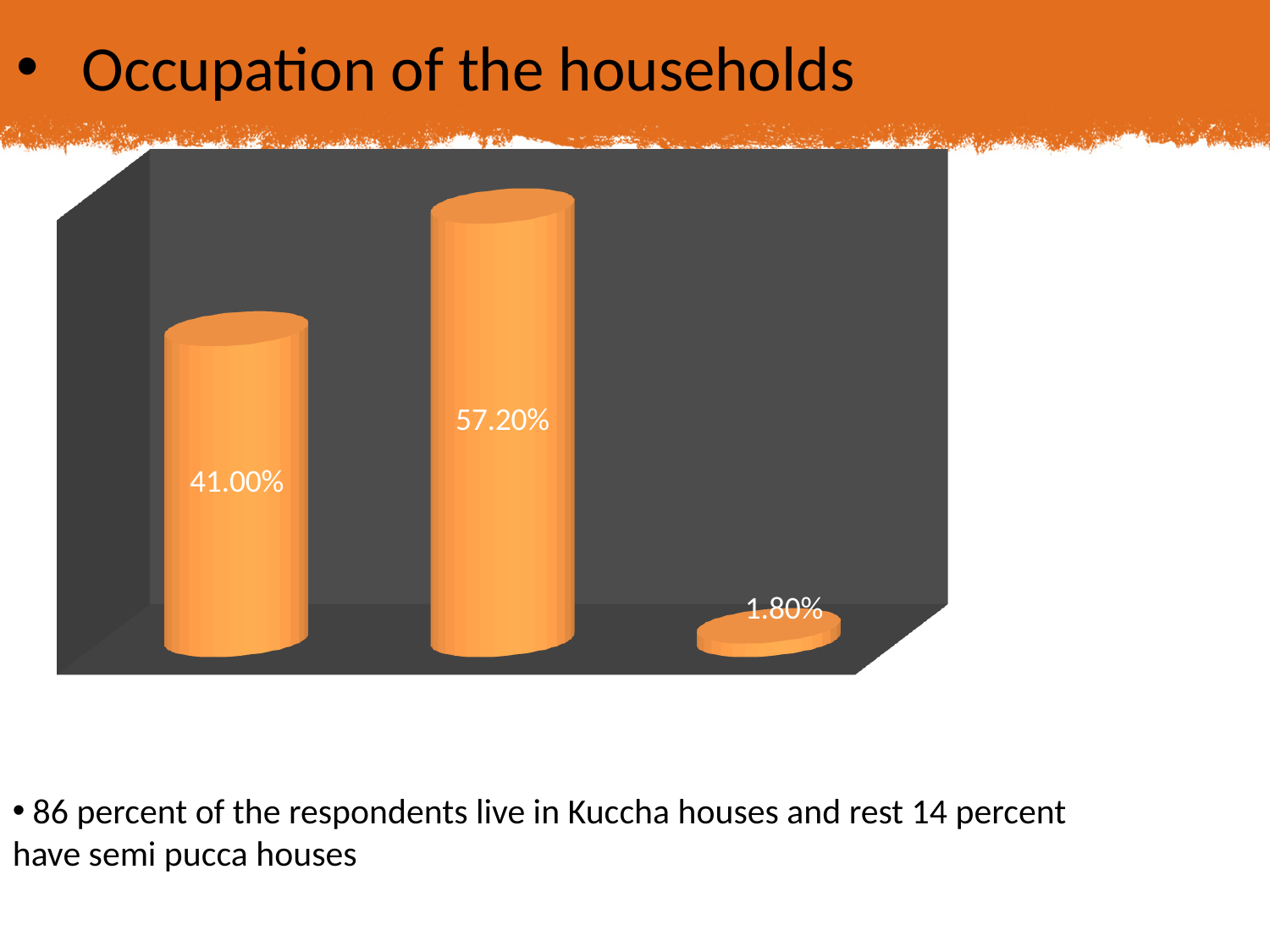
What is the difference between the middle bar's value and the left bar's value? 16.20% How many bars does the chart show? 3 What is the total of the three values labelled on the chart? 100.00% What value is labelled on the rightmost bar of the chart? 1.80% What value is labelled on the leftmost bar of the chart? 41.00% Which bar has the highest value: the left, middle or right bar? middle What kind of chart is shown on the slide? bar chart Which bar has the lowest value: the left, middle or right bar? right What value is labelled on the middle bar of the chart? 57.20% What is the difference between the left bar's value and the right bar's value? 39.20% What colour are the bars in the chart? orange Which is larger, the value of the left bar or the value of the middle bar? the middle bar